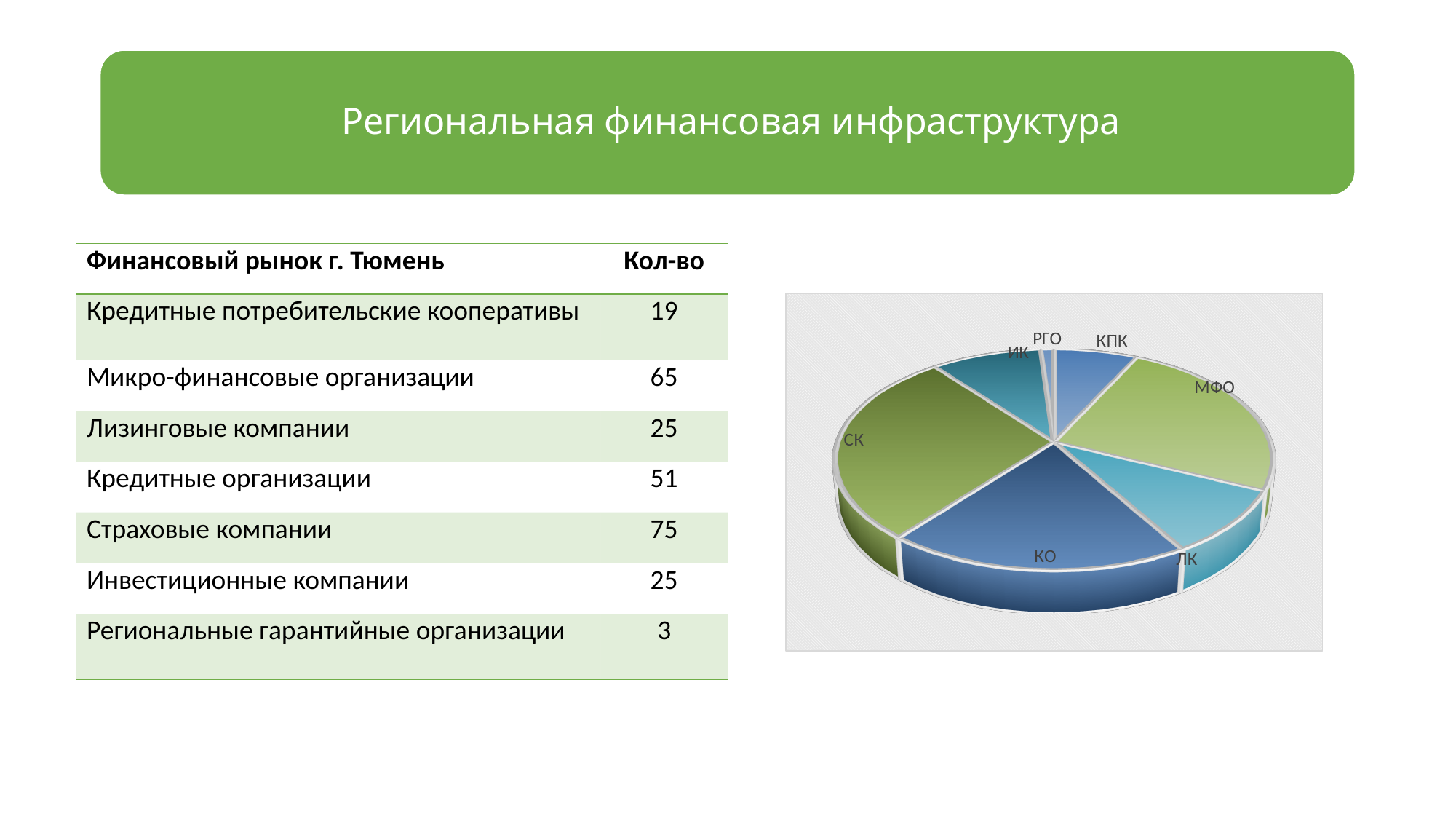
According to the table on the slide, what is the difference between the number of Микро-финансовые организации and Кредитные организации? 14 How many slices does the pie chart have? 7 In the pie chart, which slice is larger, МФО or ЛК? МФО What kind of chart is shown on the slide? pie chart In the pie chart, which slice is larger, СК or КПК? СК In the pie chart, which slice is larger, КО or ИК? КО Which slice label appears between РГО and МФО around the pie chart? КПК Which slice of the pie chart is the smallest? РГО Which slice of the pie chart is the largest? СК According to the table on the slide, how many Региональные гарантийные организации are there? 3 According to the table on the slide, how many Страховые компании are there? 75